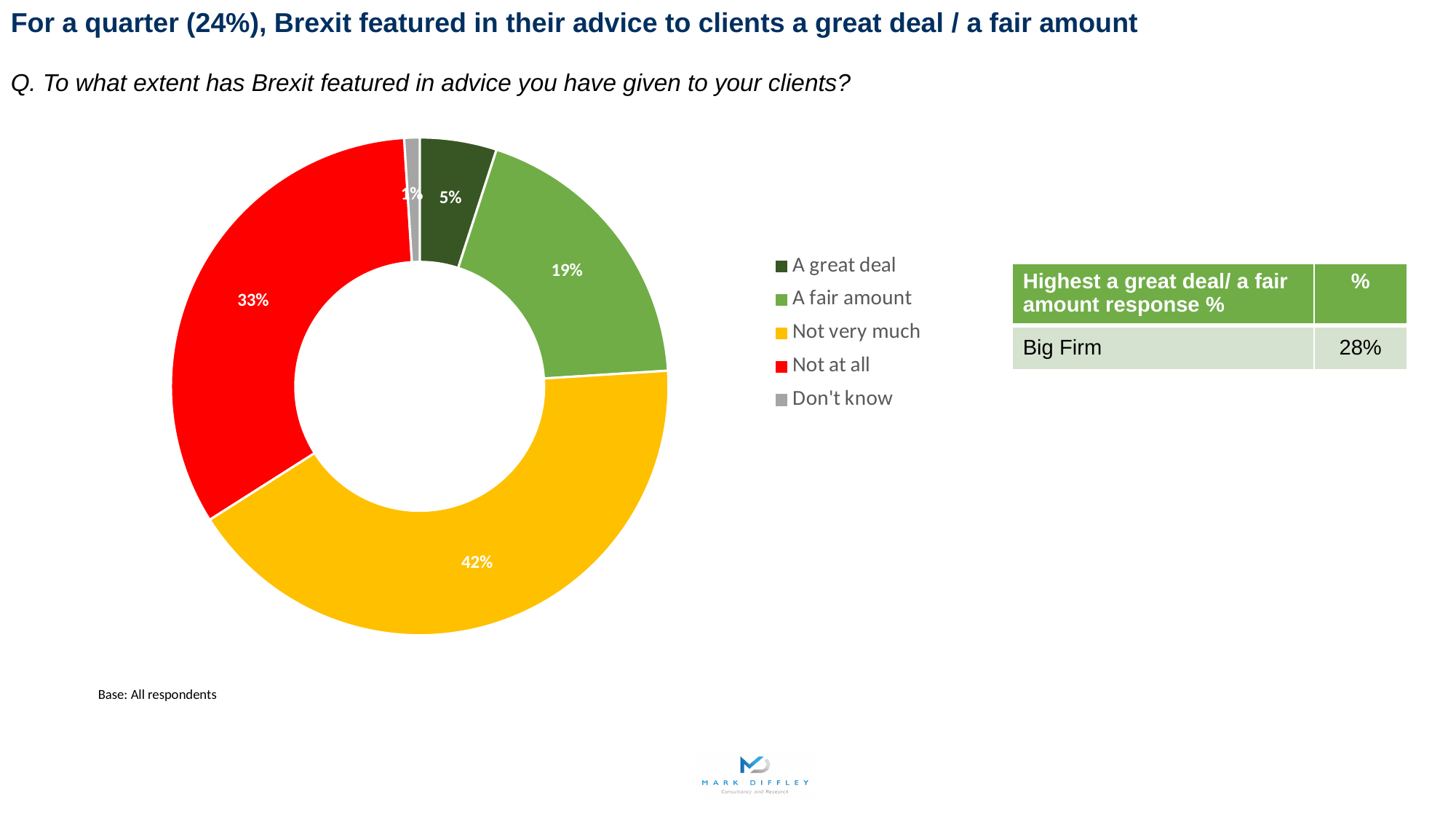
What percentage of respondents said Brexit featured 'Not very much' in their advice? 42% What percentage of respondents said Brexit featured 'Not at all' in their advice? 33% What percentage of respondents said Brexit featured 'A fair amount' in their advice? 19% How many response categories does the legend list? 5 What kind of chart is shown on the slide? Pie chart (doughnut) Which response category has the smallest share of the chart? Don't know What is the combined share of 'A great deal' and 'A fair amount'? 24% What is the difference in percentage points between 'Not very much' and 'Not at all'? 9 Which response category has the largest share of the chart? Not very much What colour represents 'Not at all' in the chart? Red Which is larger, the share for 'A fair amount' or the share for 'A great deal'? A fair amount What percentage of respondents said Brexit featured 'A great deal' in their advice? 5%